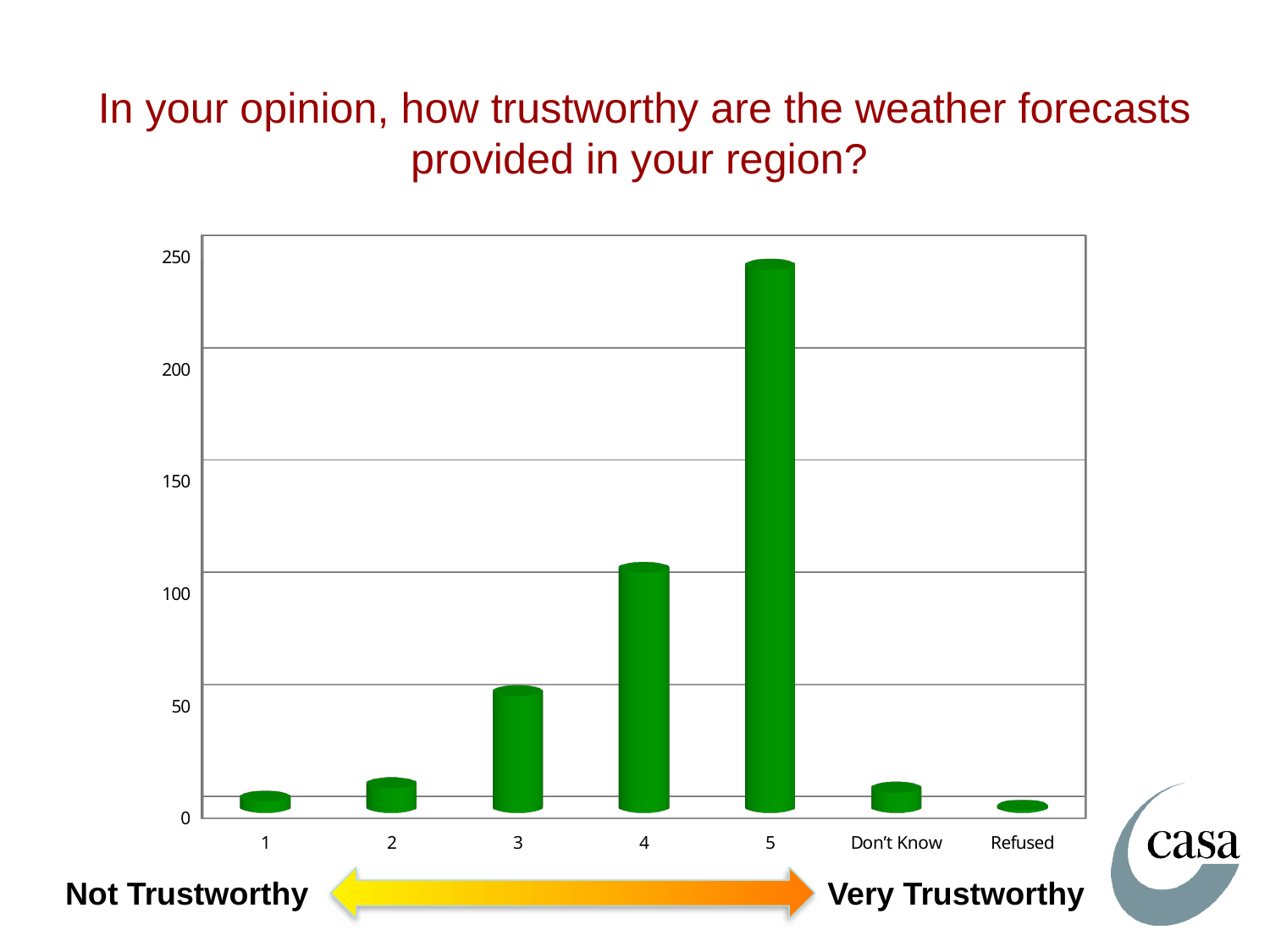
Is the value for Don't Know greater or less than 50? less Is the value for category 4 greater or less than 100? greater Which is larger, the value for category 4 or the value for category 3? 4 Among the rating categories 1 to 5, which has the lowest bar? 1 What kind of chart is shown on the slide? bar chart Do the values rise or fall from category 1 to category 5? rise Which category has the highest bar? 5 Is the value for category 5 greater or less than 200? greater What label appears at the right end of the arrow below the chart? Very Trustworthy How many categories are shown on the x axis? 7